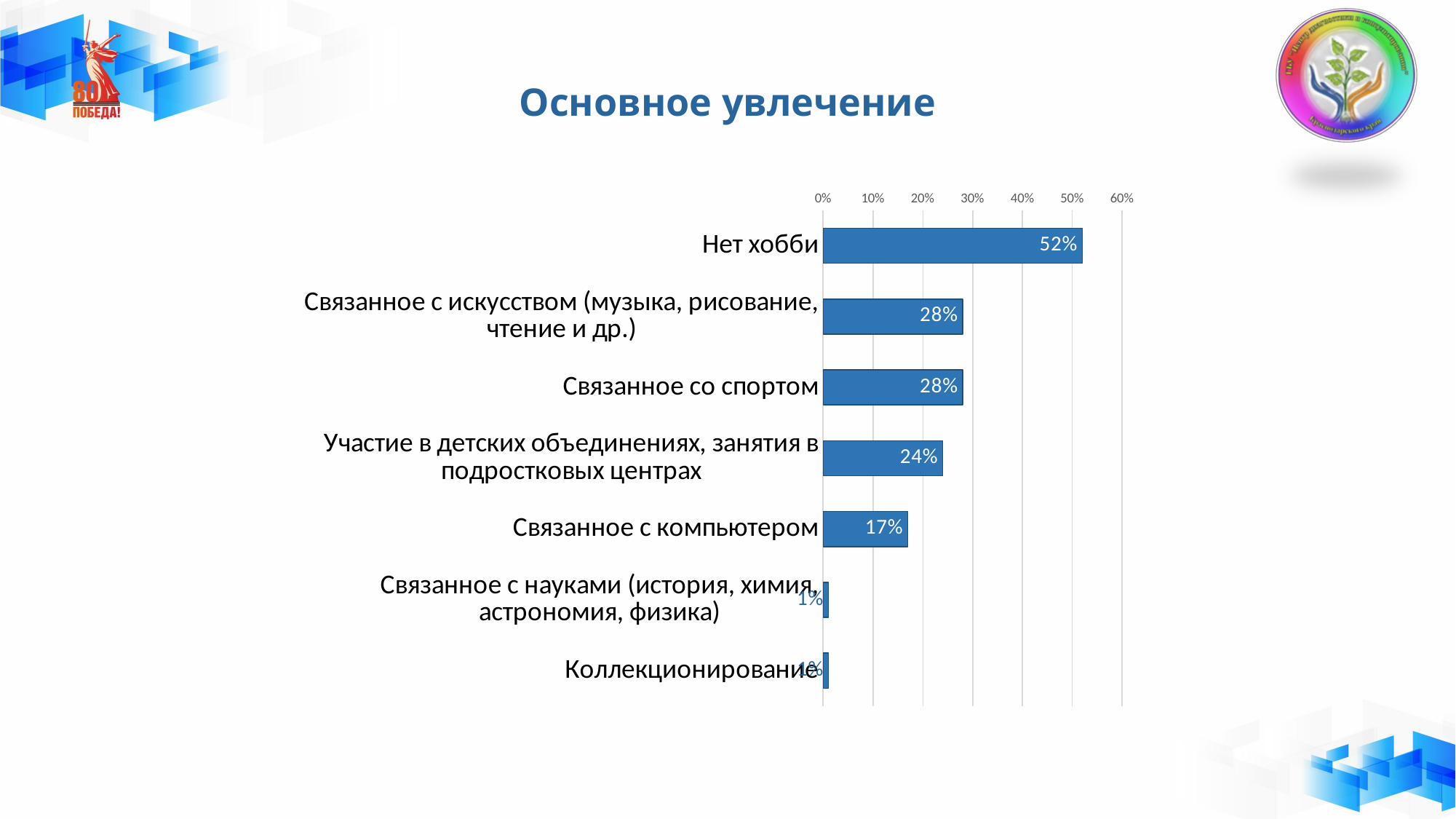
Is the value for "Нет хобби" greater or less than 50%? greater How many categories are shown in the chart? 7 Which is larger: the value for "Связанное со спортом" or the value for "Участие в детских объединениях, занятия в подростковых центрах"? Связанное со спортом What is the value for "Нет хобби"? 52% What is the difference between the values for "Нет хобби" and "Связанное с компьютером"? 35% What is the title of the chart? Основное увлечение What is the value for "Связанное с науками (история, химия, астрономия, физика)"? 1% What type of chart is shown on the slide? bar chart What is the value for "Участие в детских объединениях, занятия в подростковых центрах"? 24% What is the value for "Связанное со спортом"? 28% What is the value for "Связанное с компьютером"? 17% Which category has the highest value? Нет хобби